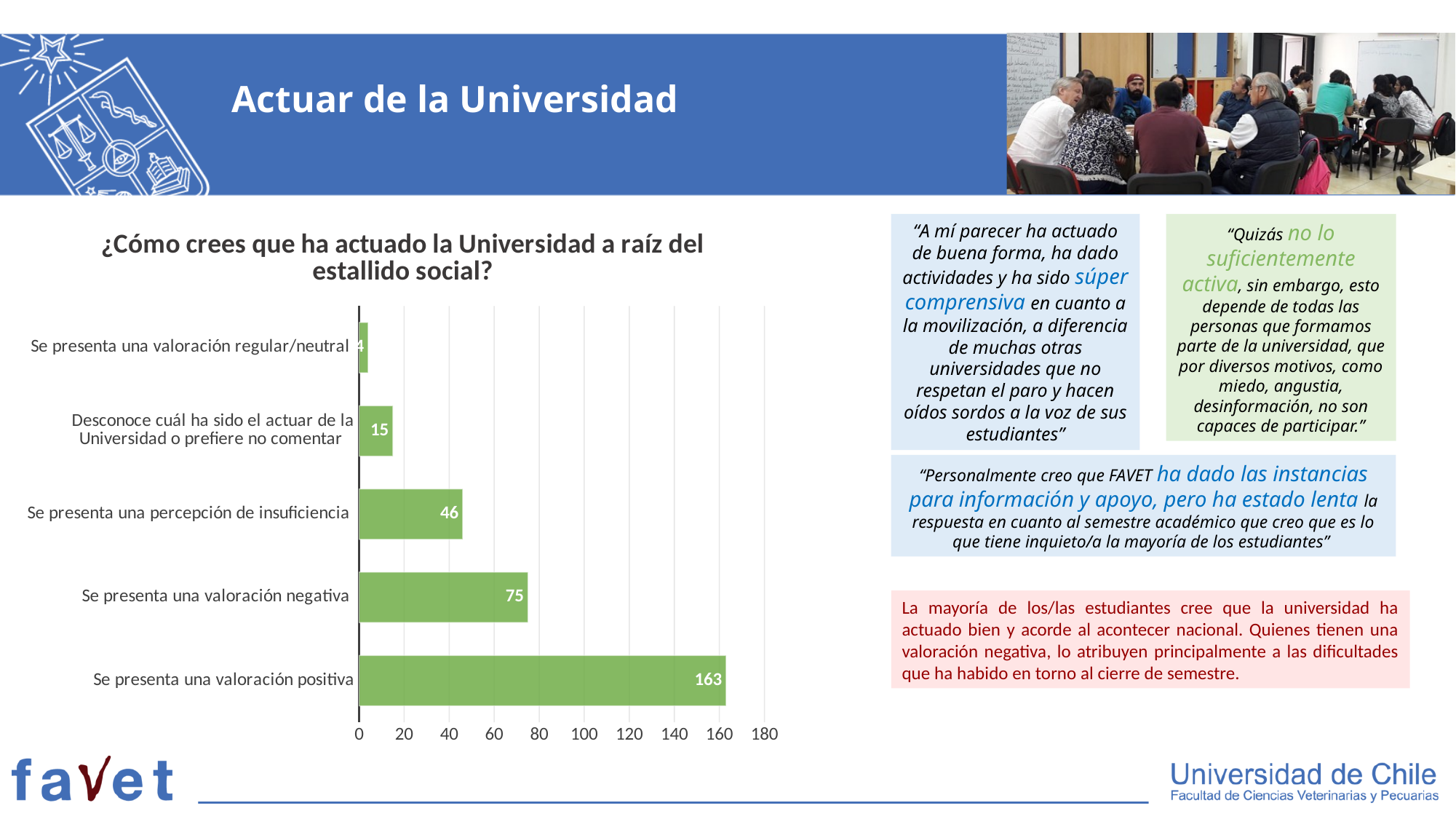
What is the title of the chart? ¿Cómo crees que ha actuado la Universidad a raíz del estallido social? What is the value for "Desconoce cuál ha sido el actuar de la Universidad o prefiere no comentar"? 15 Is the value for "Se presenta una valoración positiva" greater or less than 140? greater Which is larger: the value for "Se presenta una percepción de insuficiencia" or for "Se presenta una valoración negativa"? Se presenta una valoración negativa What is the value for "Se presenta una valoración negativa"? 75 Which category has the highest value? Se presenta una valoración positiva What kind of chart is shown on the slide? Bar chart What is the value for "Se presenta una valoración positiva"? 163 How many categories are shown in the chart? 5 What is the value for "Se presenta una percepción de insuficiencia"? 46 Which category has the lowest value? Se presenta una valoración regular/neutral What is the difference between the values for "Se presenta una valoración positiva" and "Se presenta una valoración negativa"? 88